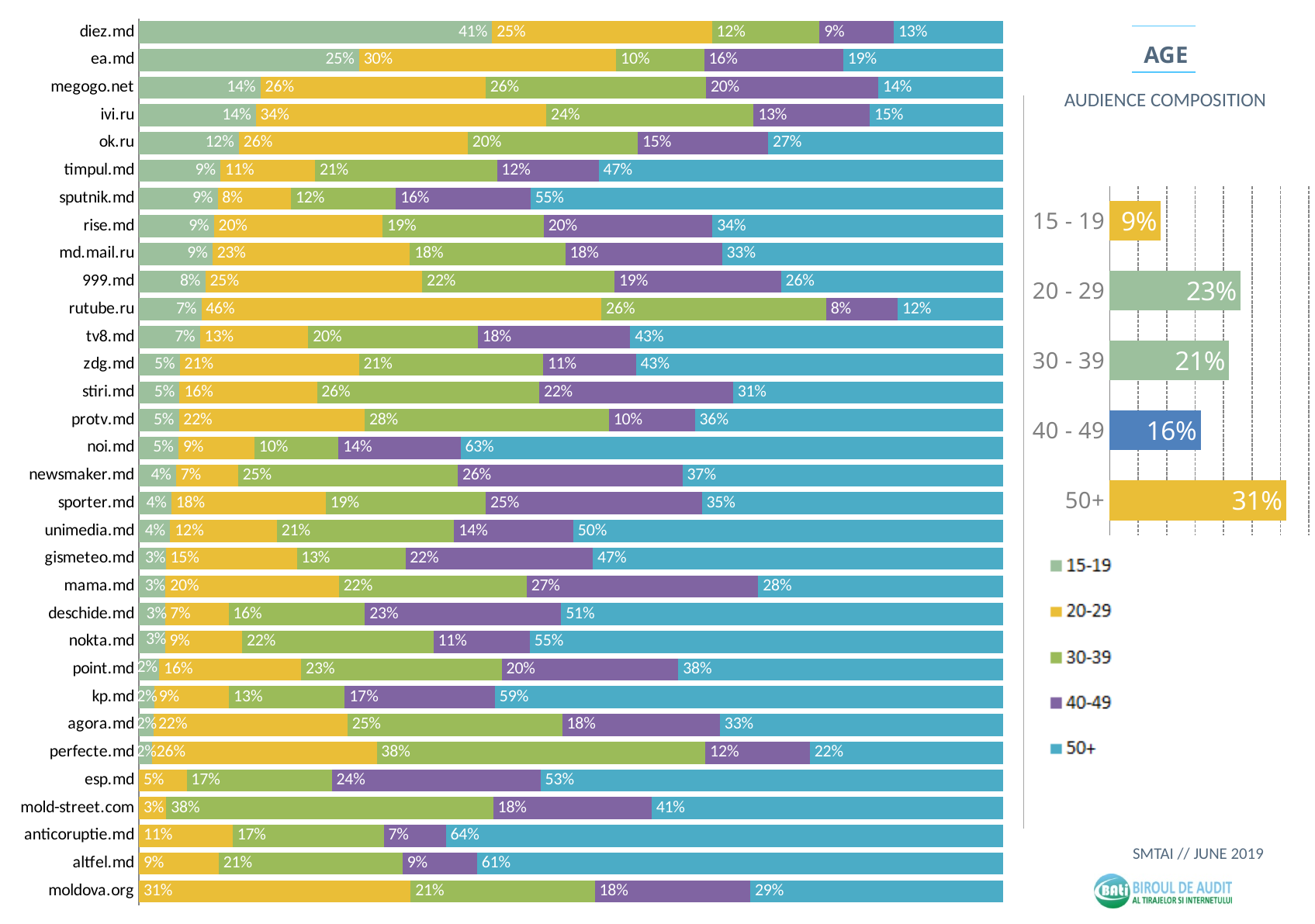
In the main chart on the left, what share of noi.md's audience is aged 50+? 63% In the main chart on the left, how many websites are listed? 32 In the main chart on the left, which website has the highest share of 15-19 year olds? diez.md In the main chart on the left, what percentage of diez.md's audience is aged 15-19? 41% In the AGE audience composition chart on the right, what is the share of the 20-29 age group? 23% In the AGE audience composition chart on the right, which age group has the smallest share? 15 - 19 In the main chart on the left, what percentage of rutube.ru's audience is in the 20-29 age group? 46% In the AGE audience composition chart on the right, which age group has the largest share? 50+ In the AGE audience composition chart on the right, what is the difference between the 50+ share and the 15-19 share? 22% What kind of chart is the main chart on the left? Stacked bar chart How many age groups does the legend list? 5 In the main chart on the left, which has the larger 50+ share, sputnik.md or timpul.md? sputnik.md